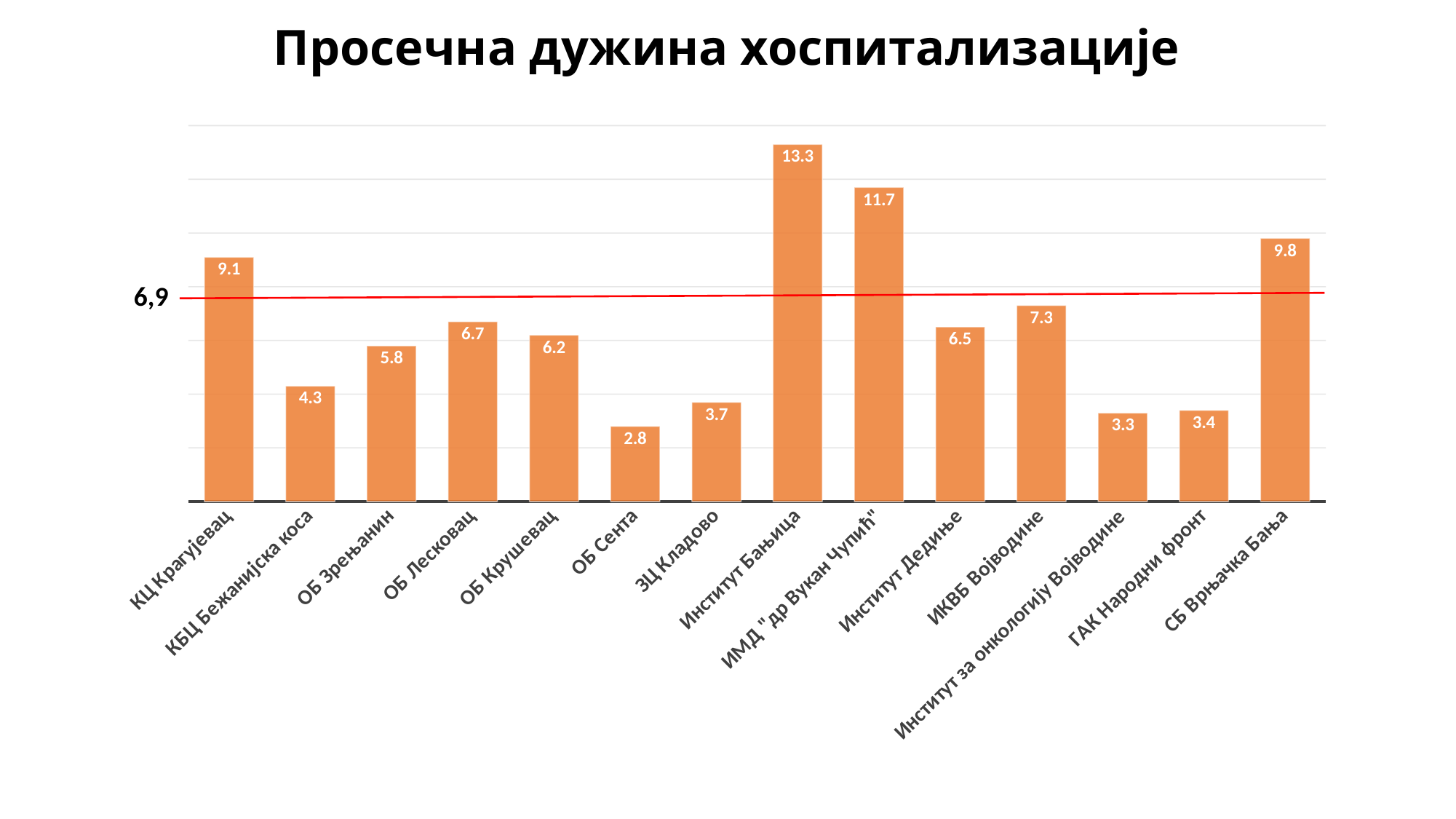
What is the title of the chart? Просечна дужина хоспитализације Which institution has the highest value? Институт Бањица Which is larger, the value for КЦ Крагујевац or the value for ИКВБ Војводине? КЦ Крагујевац What is the value for ОБ Сента? 2.8 What is the difference between the values for Институт Бањица and ИМД "др Вукан Чупић"? 1.6 Which institution has the lowest value? ОБ Сента What is the value for СБ Врњачка Бања? 9.8 What is the value for Институт Бањица? 13.3 How many institutions (categories) are shown in the chart? 14 What is the difference between the values for ГАК Народни фронт and Институт за онкологију Војводине? 0.1 What type of chart is shown on the slide? bar chart What value is marked by the red horizontal line on the chart? 6,9